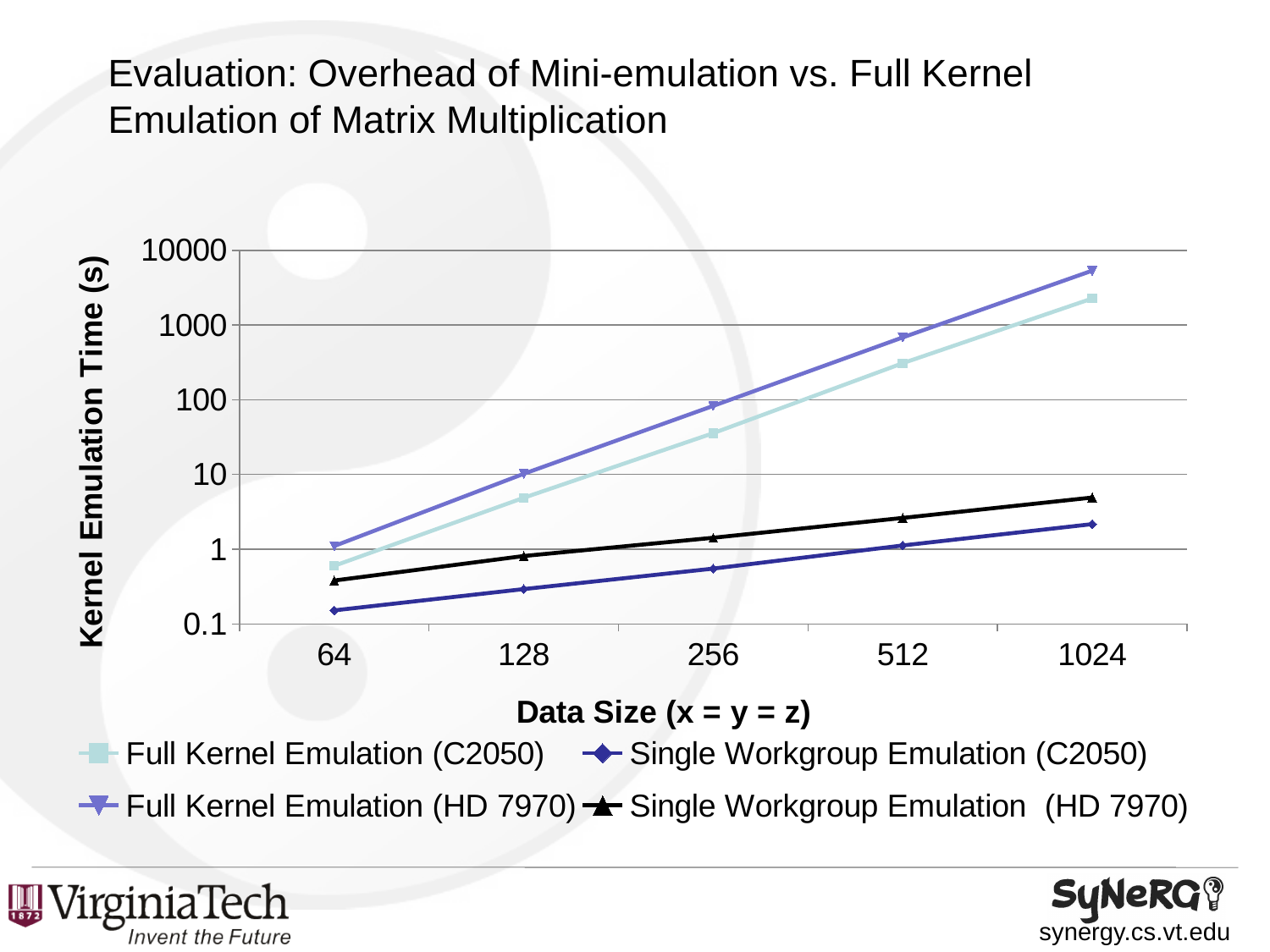
Is the value for Full Kernel Emulation (HD 7970) at data size 1024 greater or less than 1000? greater Is the value for Full Kernel Emulation (C2050) at data size 256 greater or less than 10? greater At data size 64, which is larger: Single Workgroup Emulation (HD 7970) or Single Workgroup Emulation (C2050)? Single Workgroup Emulation (HD 7970) Do the values for Full Kernel Emulation (HD 7970) rise or fall as data size increases? Rise At data size 1024, which is larger: Full Kernel Emulation (HD 7970) or Full Kernel Emulation (C2050)? Full Kernel Emulation (HD 7970) What is the title of the y axis? Kernel Emulation Time (s) Which series has the highest kernel emulation time at data size 1024? Full Kernel Emulation (HD 7970) How many series does the legend list? 4 Is the value for Single Workgroup Emulation (C2050) at data size 64 greater or less than 1? less Which series has the lowest kernel emulation time at data size 64? Single Workgroup Emulation (C2050) What kind of chart is shown on the slide? Line chart How many data sizes are plotted along the x axis? 5